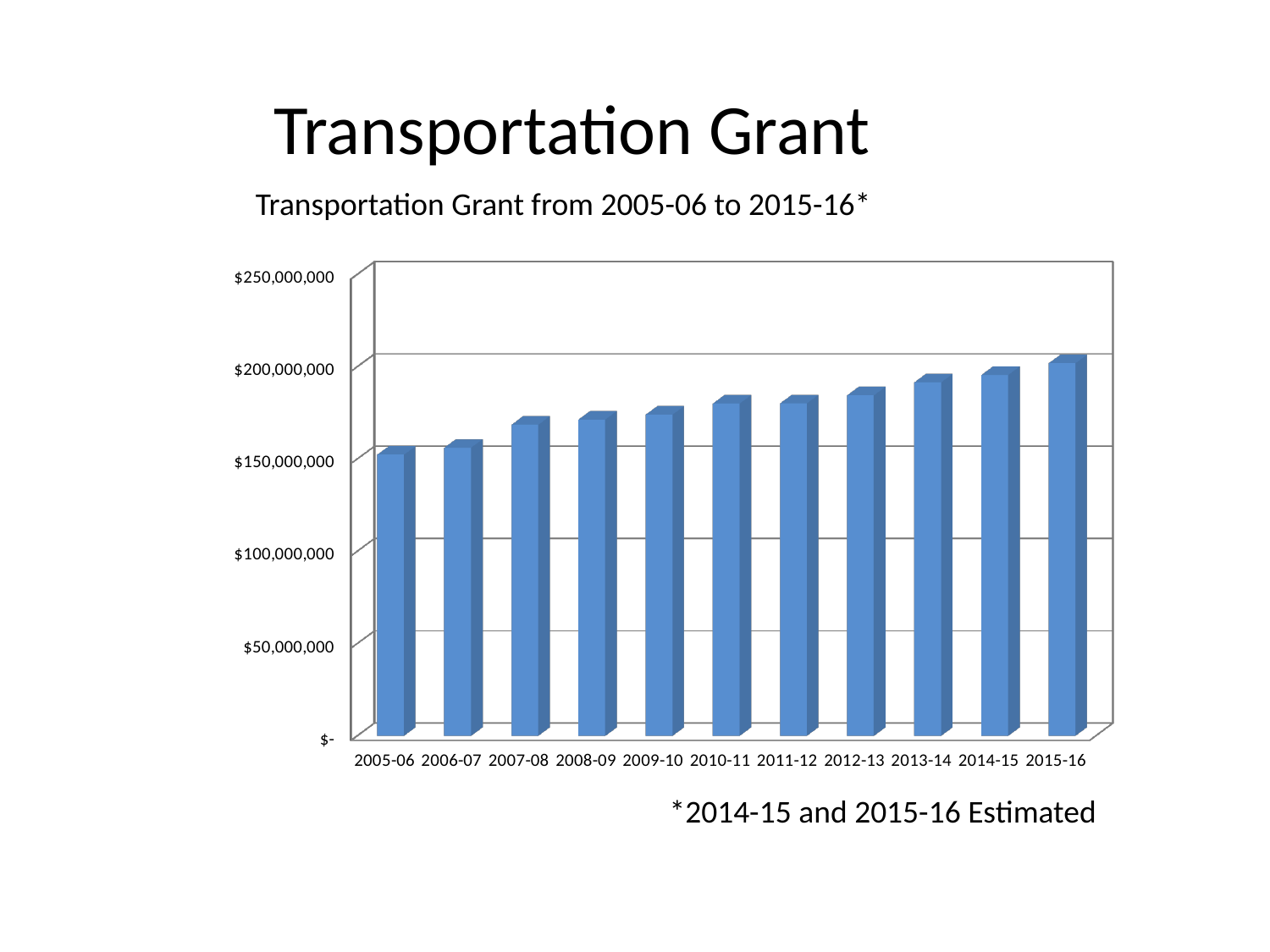
Is the value for 2006-07 greater or less than $200,000,000? less Which fiscal year has the highest Transportation Grant value? 2015-16 Which fiscal years does the footnote say are estimated? 2014-15 and 2015-16 Is the value for 2013-14 greater or less than $150,000,000? greater What kind of chart is shown on the slide? bar chart Which fiscal year has the lowest Transportation Grant value? 2005-06 What is the title of the chart? Transportation Grant from 2005-06 to 2015-16* Do the Transportation Grant values generally rise or fall from 2005-06 to 2015-16? rise How many fiscal years are shown on the x axis of the chart? 11 Is the value for 2007-08 greater or less than $150,000,000? greater Which is larger, the value for 2013-14 or the value for 2007-08? 2013-14